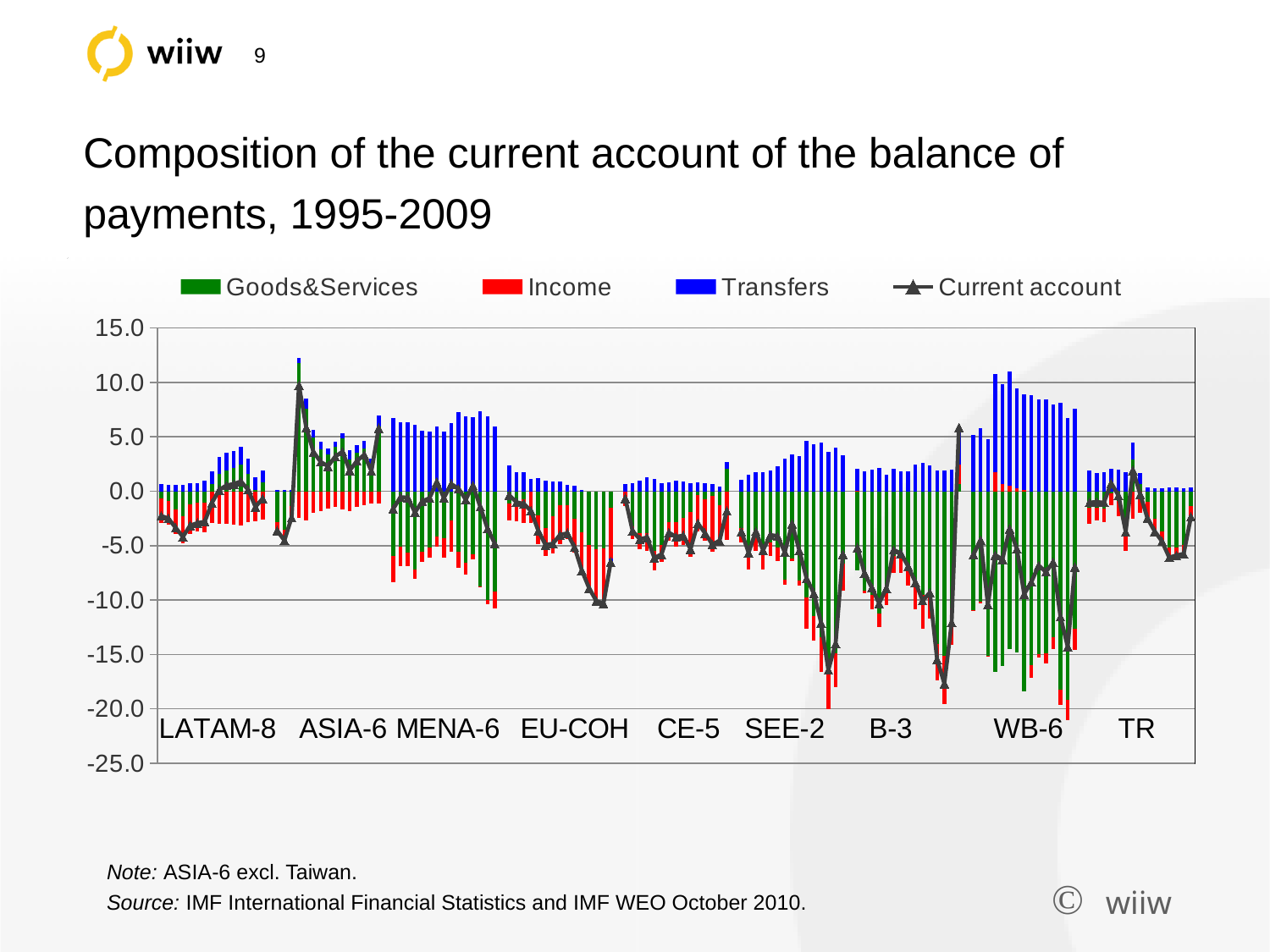
Is the tallest Transfers bar in the WB-6 group greater or less than 10.0? greater Which series is plotted as a line with triangle markers? Current account What is the lowest value shown on the y axis? -25.0 Which colour represents Transfers in the chart? Blue Which regional group has the tallest positive Transfers bars? WB-6 What kind of chart is shown on the slide? Stacked bar chart with a line overlay Is the peak of the Current account line in the ASIA-6 group greater or less than 5.0? greater Is the lowest point of the Current account line in the SEE-2 group greater or less than -10.0? less How many regional groups are labelled along the x axis? 9 How many series does the legend list? 4